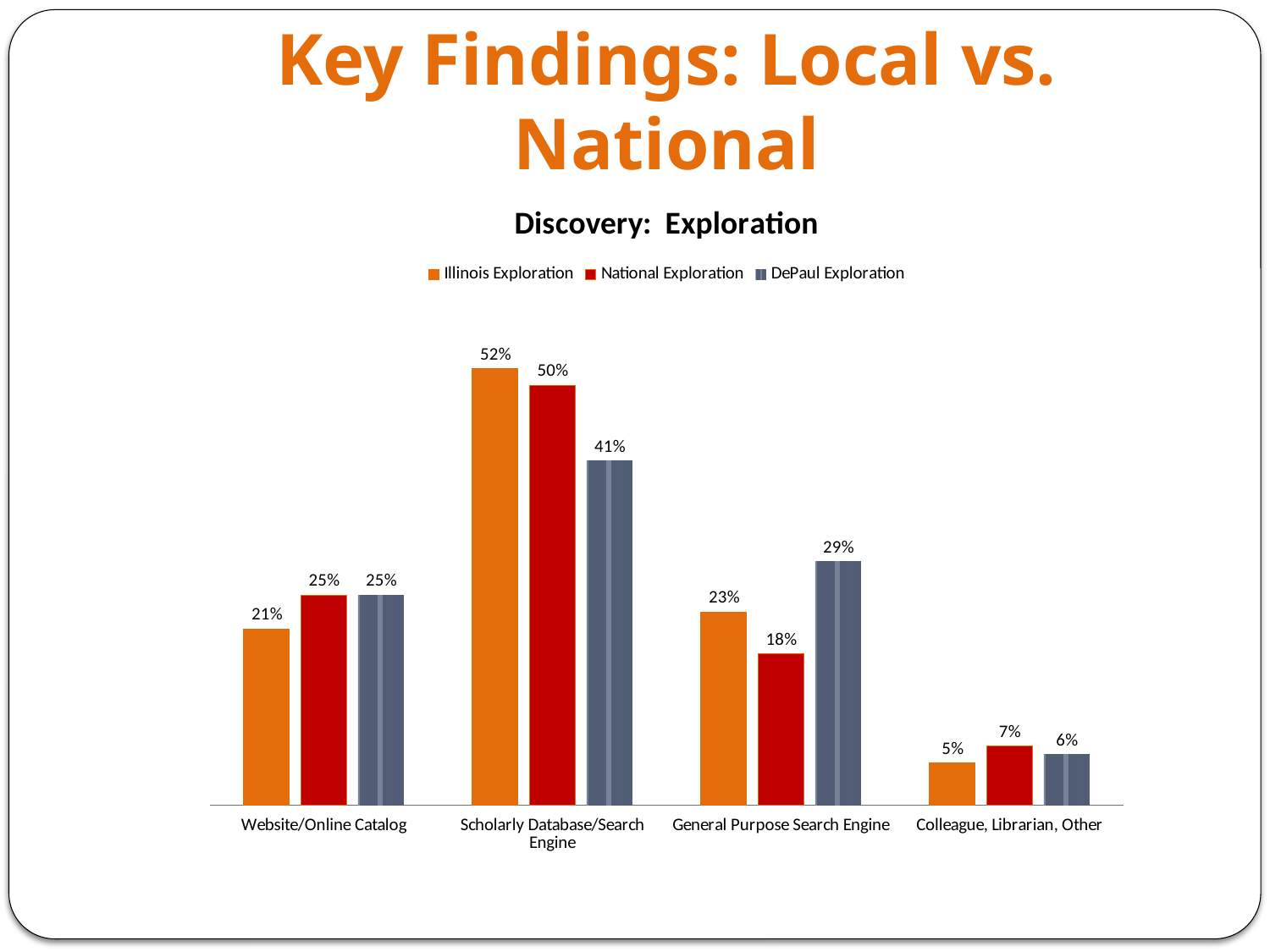
For General Purpose Search Engine, which is larger: Illinois Exploration or National Exploration? Illinois Exploration What is the difference between the National Exploration and Illinois Exploration values for Website/Online Catalog? 4% How many categories are shown on the x axis? 4 What is the difference between the Illinois Exploration and DePaul Exploration values for Scholarly Database/Search Engine? 11% Which category has the highest Illinois Exploration value? Scholarly Database/Search Engine Which category has the lowest DePaul Exploration value? Colleague, Librarian, Other How many series does the legend list? 3 What is the DePaul Exploration value for General Purpose Search Engine? 29% What kind of chart is shown on the slide? Bar chart What is the Illinois Exploration value for Scholarly Database/Search Engine? 52% What is the National Exploration value for Colleague, Librarian, Other? 7% What is the title of the chart? Discovery: Exploration